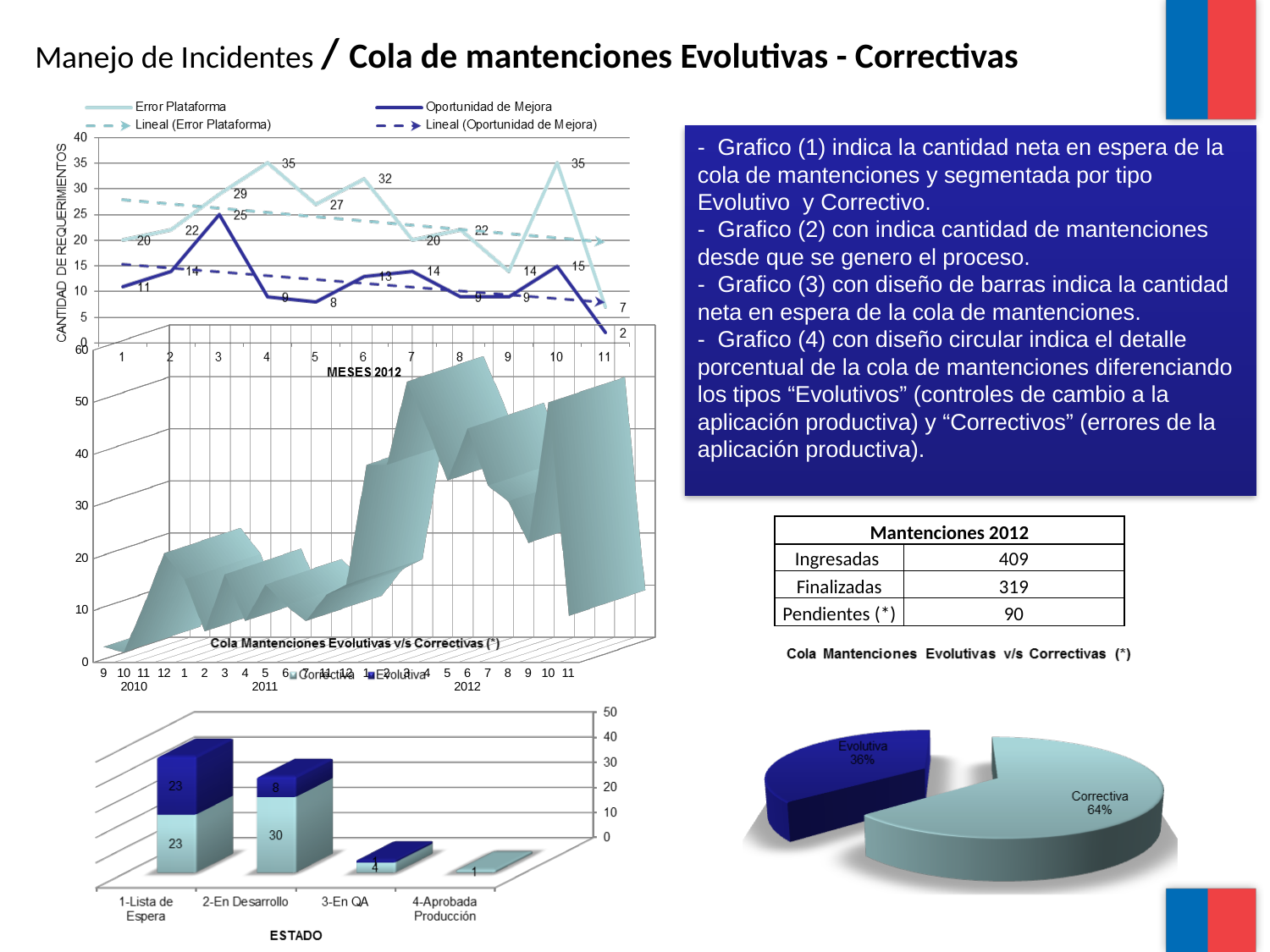
In the pie chart at the bottom right, what share does Correctiva have? 64% In the top-left line chart (Error Plataforma / Oportunidad de Mejora), what is the value of Error Plataforma in month 4? 35 In the bottom-left bar chart, what is the total of the stacked bar for 1-Lista de Espera? 46 In the top-left line chart, in which month does Oportunidad de Mejora reach its highest value? 3 In the bottom-left bar chart 'Cola Mantenciones Evolutivas v/s Correctivas', what is the Evolutiva value for 2-En Desarrollo? 8 In the top-left line chart, in which month is Oportunidad de Mejora lowest? 11 In the bottom-left bar chart 'Cola Mantenciones Evolutivas v/s Correctivas', what is the Correctiva value for 2-En Desarrollo? 30 How many months are plotted on the x axis of the top-left line chart? 11 In the top-left line chart, what is the value of Oportunidad de Mejora in month 3? 25 In the top-left line chart, what is the difference between Error Plataforma and Oportunidad de Mejora in month 6? 19 How many entries does the legend of the top-left line chart list? 4 What kind of chart is the bottom-left chart titled 'Cola Mantenciones Evolutivas v/s Correctivas'? bar chart